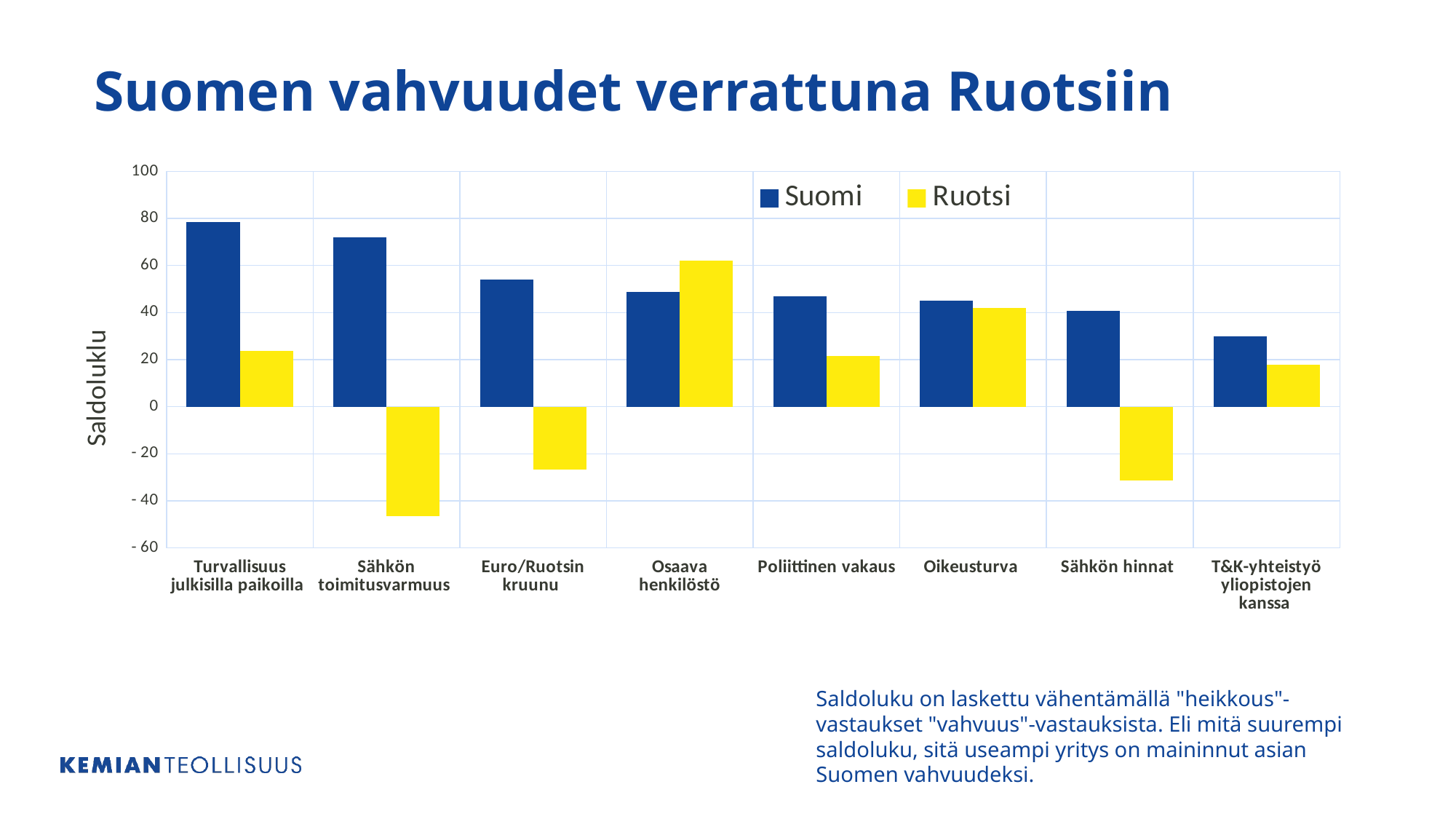
For Osaava henkilöstö, which series has the larger value, Suomi or Ruotsi? Ruotsi Which category has the lowest value for Suomi? T&K-yhteistyö yliopistojen kanssa Is the value for Ruotsi in Sähkön toimitusvarmuus greater or less than -40? less Which category has the highest value for Ruotsi? Osaava henkilöstö How many series does the legend list? 2 How many categories are shown on the x axis? 8 Which category has the lowest value for Ruotsi? Sähkön toimitusvarmuus Is the value for Suomi in Turvallisuus julkisilla paikoilla greater or less than 60? greater Which category has the highest value for Suomi? Turvallisuus julkisilla paikoilla What is the label of the vertical axis? Saldoluku Do the Suomi values rise or fall from left to right along the x axis? fall What kind of chart is shown on the slide? Bar chart